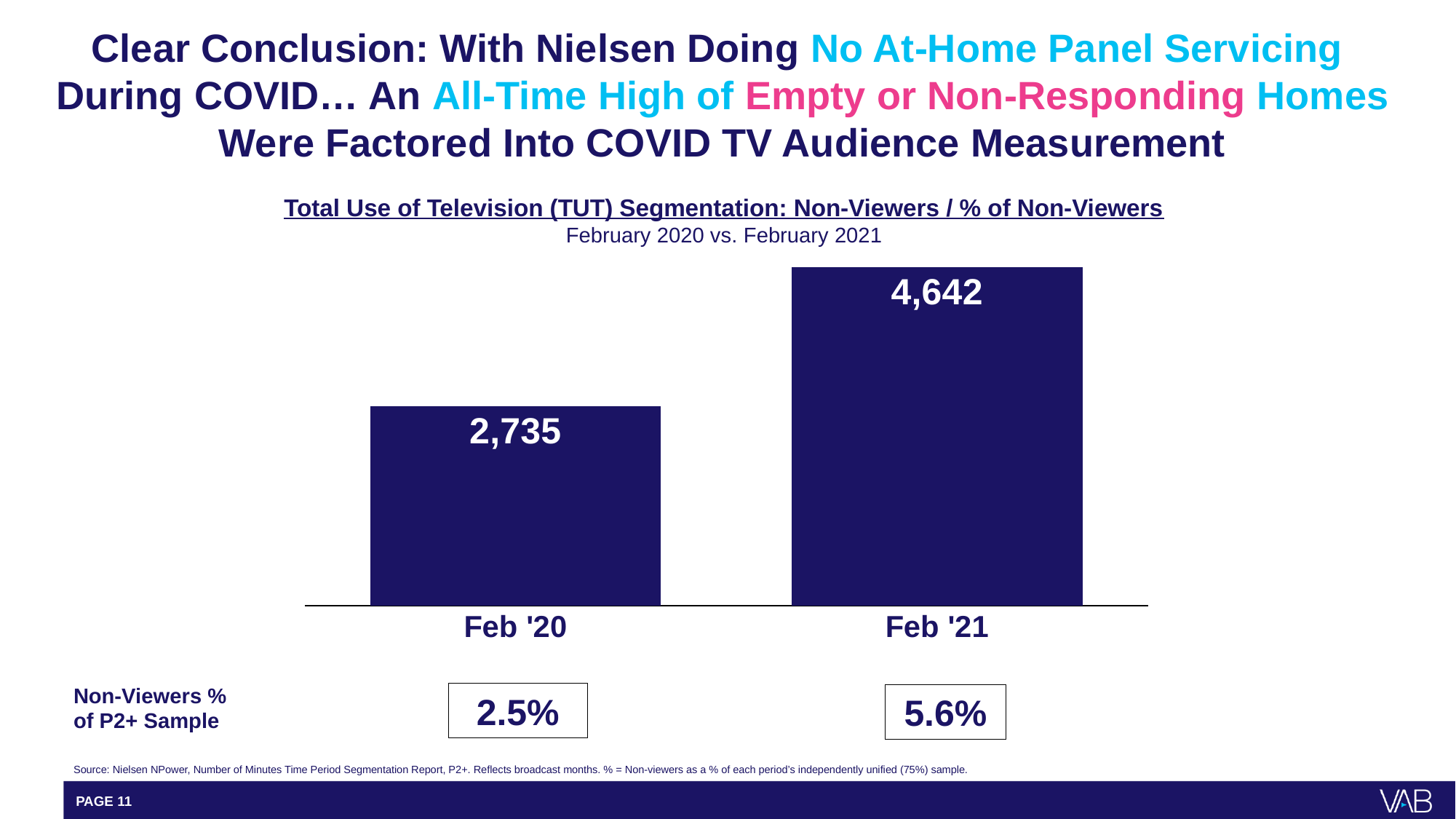
Which period has the lower number of non-viewers? Feb '20 What is the difference in non-viewers between Feb '21 and Feb '20? 1,907 What is the Non-Viewers % of P2+ Sample shown for Feb '20? 2.5% Which period has the higher number of non-viewers? Feb '21 How many categories are plotted on the chart? 2 Do the non-viewer values rise or fall from Feb '20 to Feb '21? rise What two periods does the chart subtitle say are being compared? February 2020 vs. February 2021 What is the number of non-viewers shown for Feb '20? 2,735 What kind of chart is shown on the slide? bar chart Is the non-viewers value for Feb '20 larger or smaller than the value for Feb '21? smaller What is the Non-Viewers % of P2+ Sample shown for Feb '21? 5.6% What is the number of non-viewers shown for Feb '21? 4,642